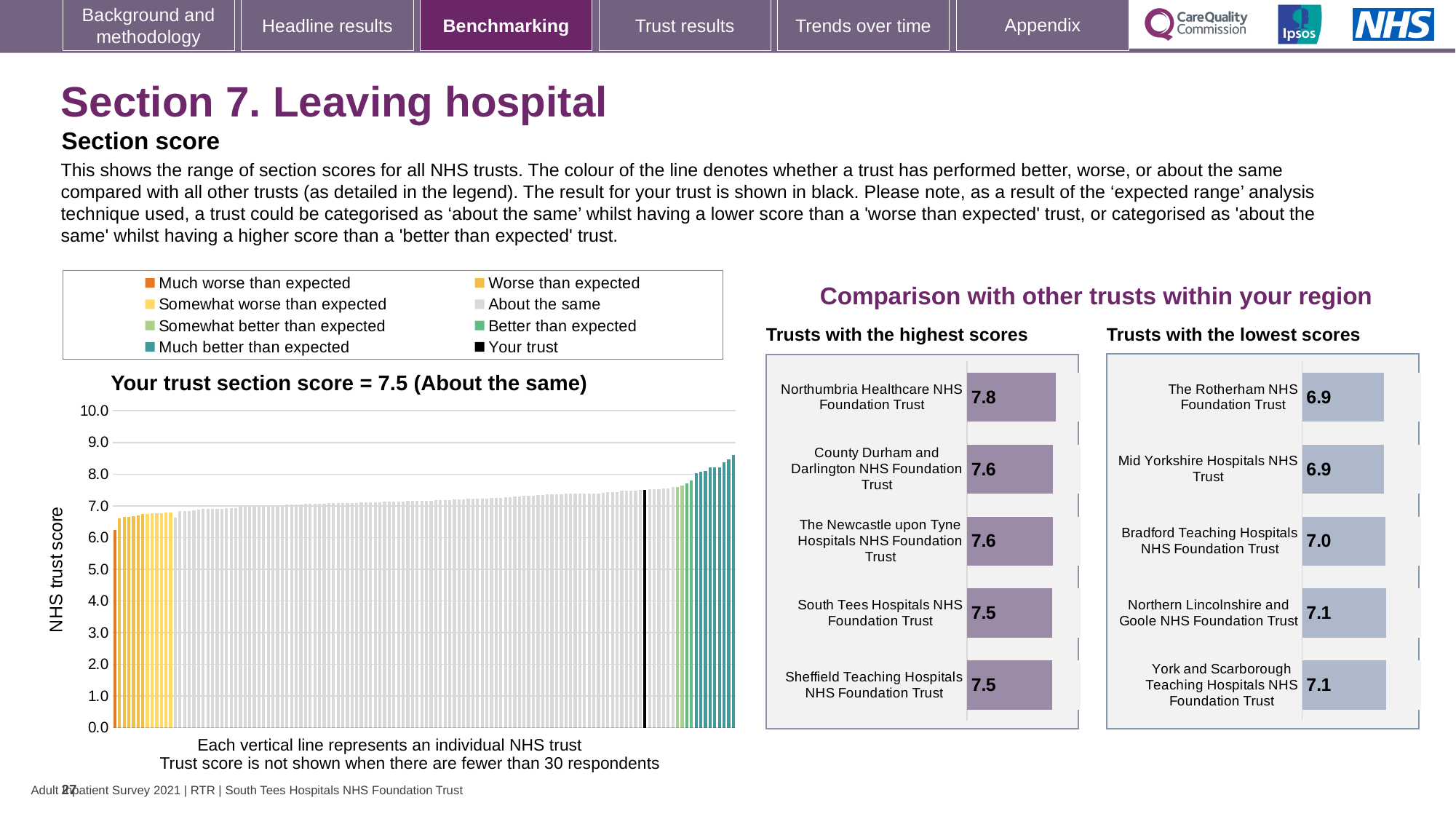
According to the title of the large chart on the left, what is your trust's section score? 7.5 In the 'Trusts with the lowest scores' chart, which has the larger score: Bradford Teaching Hospitals NHS Foundation Trust or The Rotherham NHS Foundation Trust? Bradford Teaching Hospitals NHS Foundation Trust In the 'Trusts with the highest scores' chart, what is the score for Northumbria Healthcare NHS Foundation Trust? 7.8 What is the label on the vertical axis of the large chart on the left? NHS trust score In the 'Trusts with the lowest scores' chart, what is the difference between the scores of York and Scarborough Teaching Hospitals NHS Foundation Trust and The Rotherham NHS Foundation Trust? 0.2 In the 'Trusts with the lowest scores' chart, what is the score for Bradford Teaching Hospitals NHS Foundation Trust? 7.0 How many trusts are shown in the 'Trusts with the lowest scores' chart? 5 In the 'Trusts with the highest scores' chart, which trust has the highest score? Northumbria Healthcare NHS Foundation Trust What kind of chart is the large chart on the left showing the range of section scores for all NHS trusts? Bar chart In the large chart on the left, do the trust scores rise or fall from left to right? Rise In the 'Trusts with the highest scores' chart, what is the difference between the scores of Northumbria Healthcare NHS Foundation Trust and Sheffield Teaching Hospitals NHS Foundation Trust? 0.3 How many trusts are shown in the 'Trusts with the highest scores' chart? 5